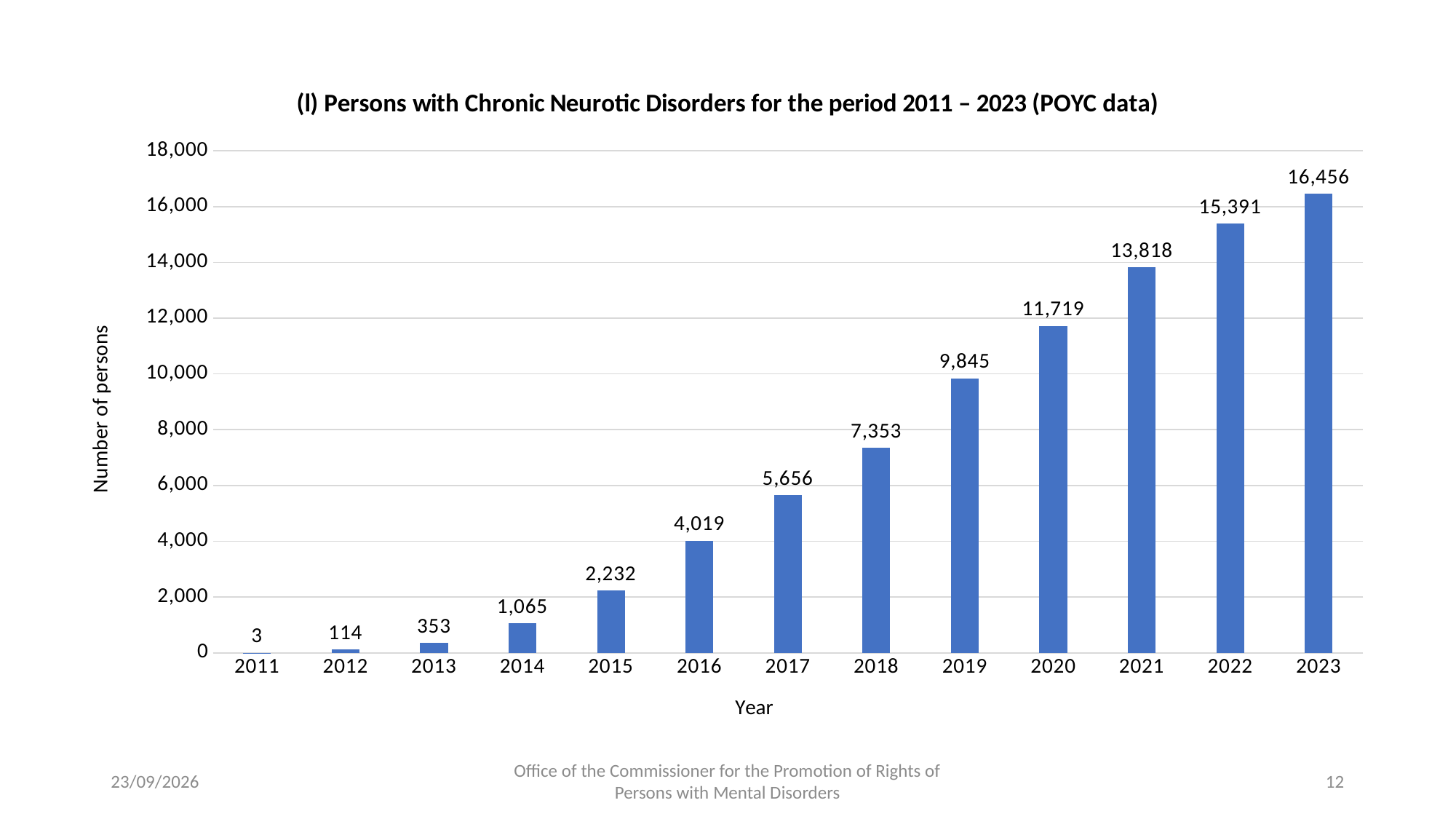
What is the difference between the values for 2023 and 2022? 1,065 What is the number of persons shown for 2013? 353 Do the values rise or fall from 2011 to 2023? Rise Which year has a larger value, 2016 or 2017? 2017 What kind of chart is this? Bar chart Which year has the lowest number of persons? 2011 What is the number of persons with chronic neurotic disorders in 2018? 7,353 Which year has the highest number of persons? 2023 What is the value for 2021? 13,818 What is the difference between the values for 2020 and 2019? 1,874 How many years are shown on the x axis? 13 Is the value for 2020 greater or less than 10,000? greater